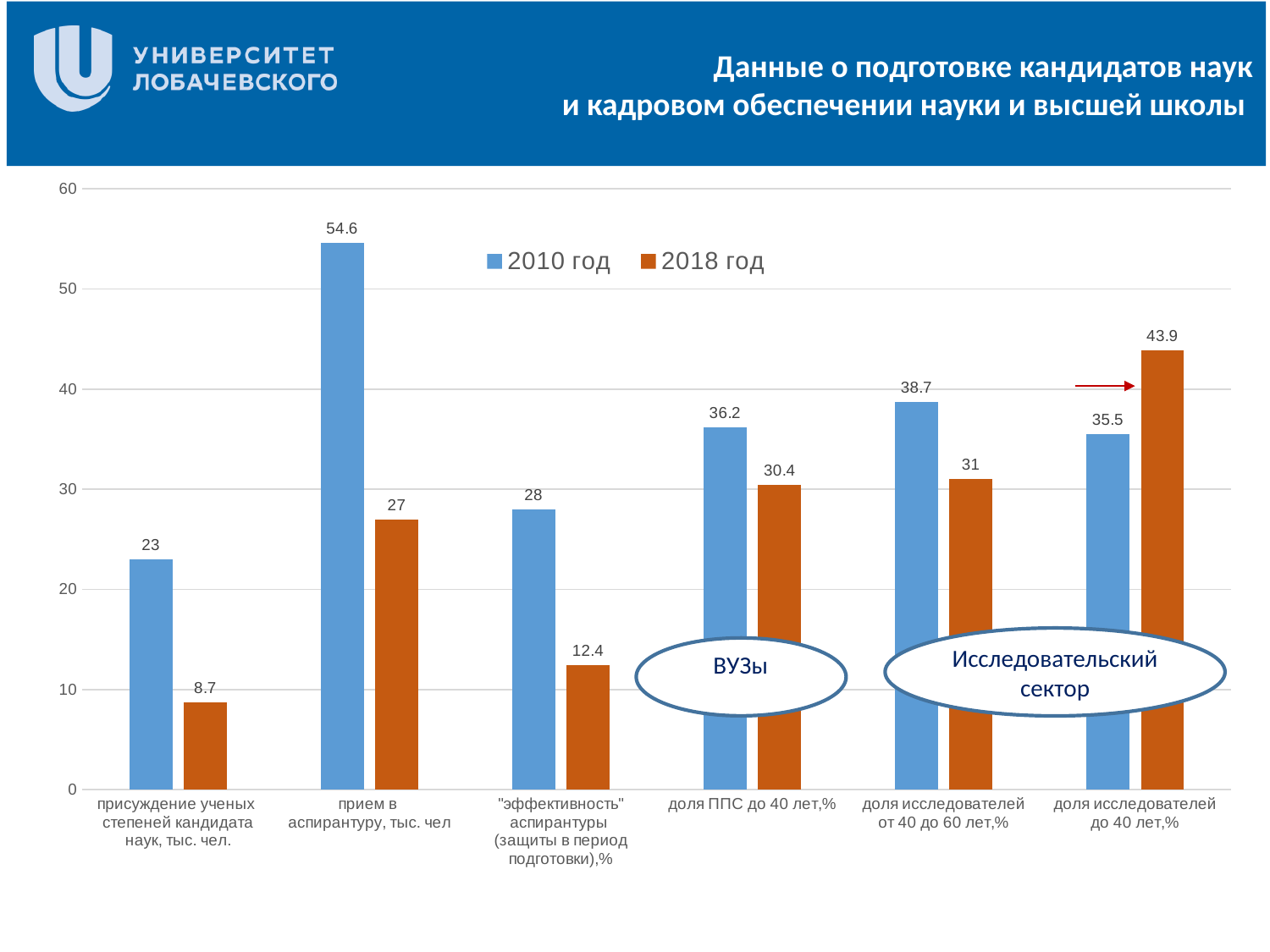
Which category has the lowest 2018 год value? присуждение ученых степеней кандидата наук, тыс. чел. What is the 2010 год value for "прием в аспирантуру, тыс. чел"? 54.6 What is the difference between the 2010 год and 2018 год values for "эффективность" аспирантуры? 15.6 What kind of chart is shown on the slide? bar chart Which colour represents the 2018 год series? orange How many categories are shown on the x axis? 6 How many series does the legend list? 2 For "доля исследователей до 40 лет,%", which series has the larger value, 2010 год or 2018 год? 2018 год What is the 2018 год value for "доля исследователей до 40 лет,%"? 43.9 Which category has the highest 2010 год value? прием в аспирантуру, тыс. чел Is the 2018 год value for "доля ППС до 40 лет,%" greater or less than 40? less What is the 2018 год value for "присуждение ученых степеней кандидата наук, тыс. чел."? 8.7